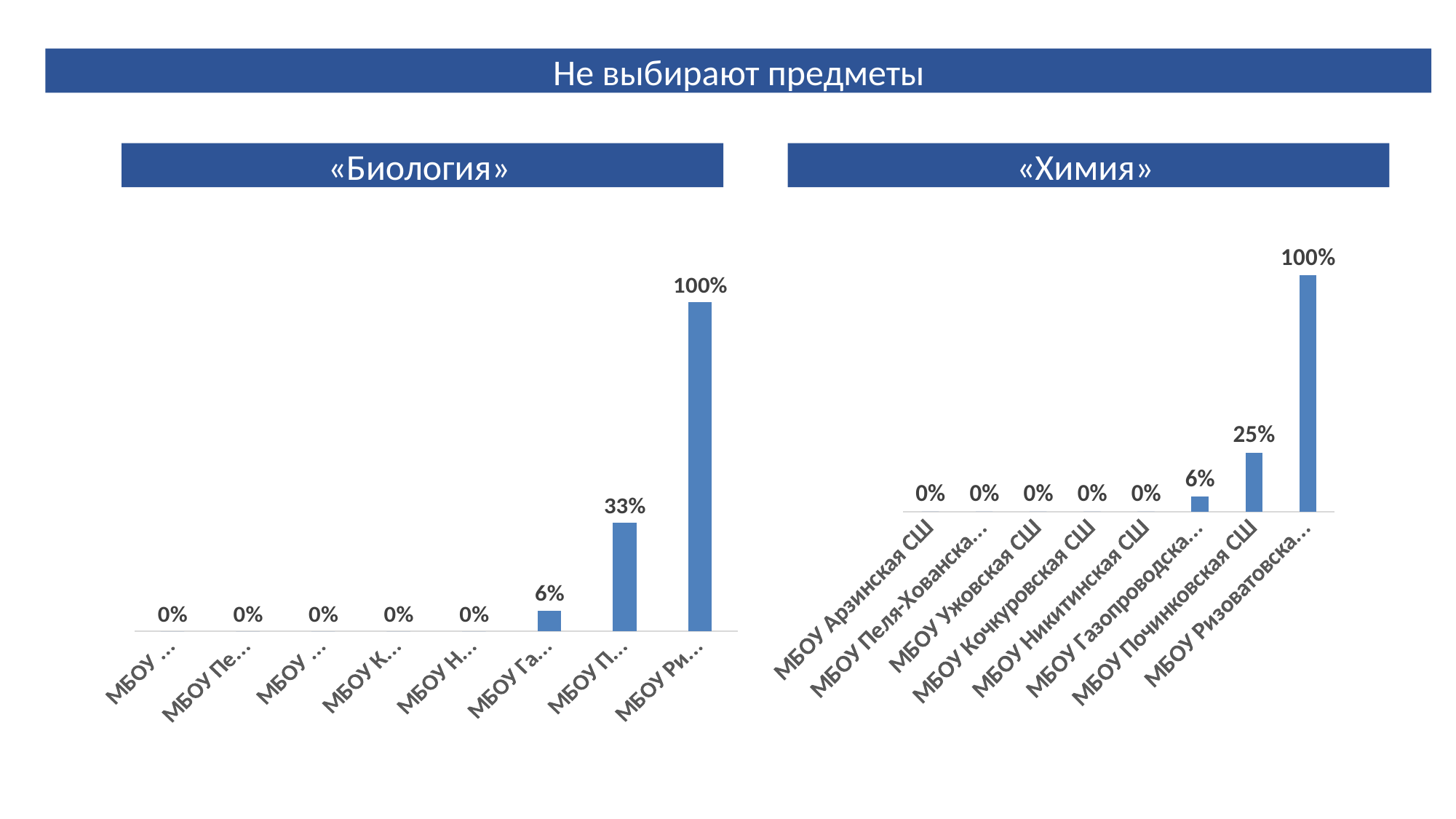
On the «Химия» chart, which has a larger value: МБОУ Починковская СШ or МБОУ Кочкуровская СШ? МБОУ Починковская СШ On the «Биология» chart, what is the value of the rightmost bar? 100% On the «Химия» chart, what is the difference between the value for МБОУ Починковская СШ and the 6% bar next to it? 19 percentage points On the «Химия» chart, do the values rise or fall from left to right? Rise On the «Биология» chart, what is the value of the seventh bar from the left? 33% On the «Биология» chart, what is the difference between the two highest values (100% and 33%)? 67 percentage points On the «Химия» chart, what is the value for МБОУ Арзинская СШ? 0% What type of chart is the «Биология» chart? Bar chart How many categories (schools) are shown on the «Химия» chart? 8 On the «Химия» chart, what is the highest value shown? 100% On the «Химия» chart, what is the value for МБОУ Починковская СШ? 25% On the «Химия» chart, what is the value for МБОУ Никитинская СШ? 0%